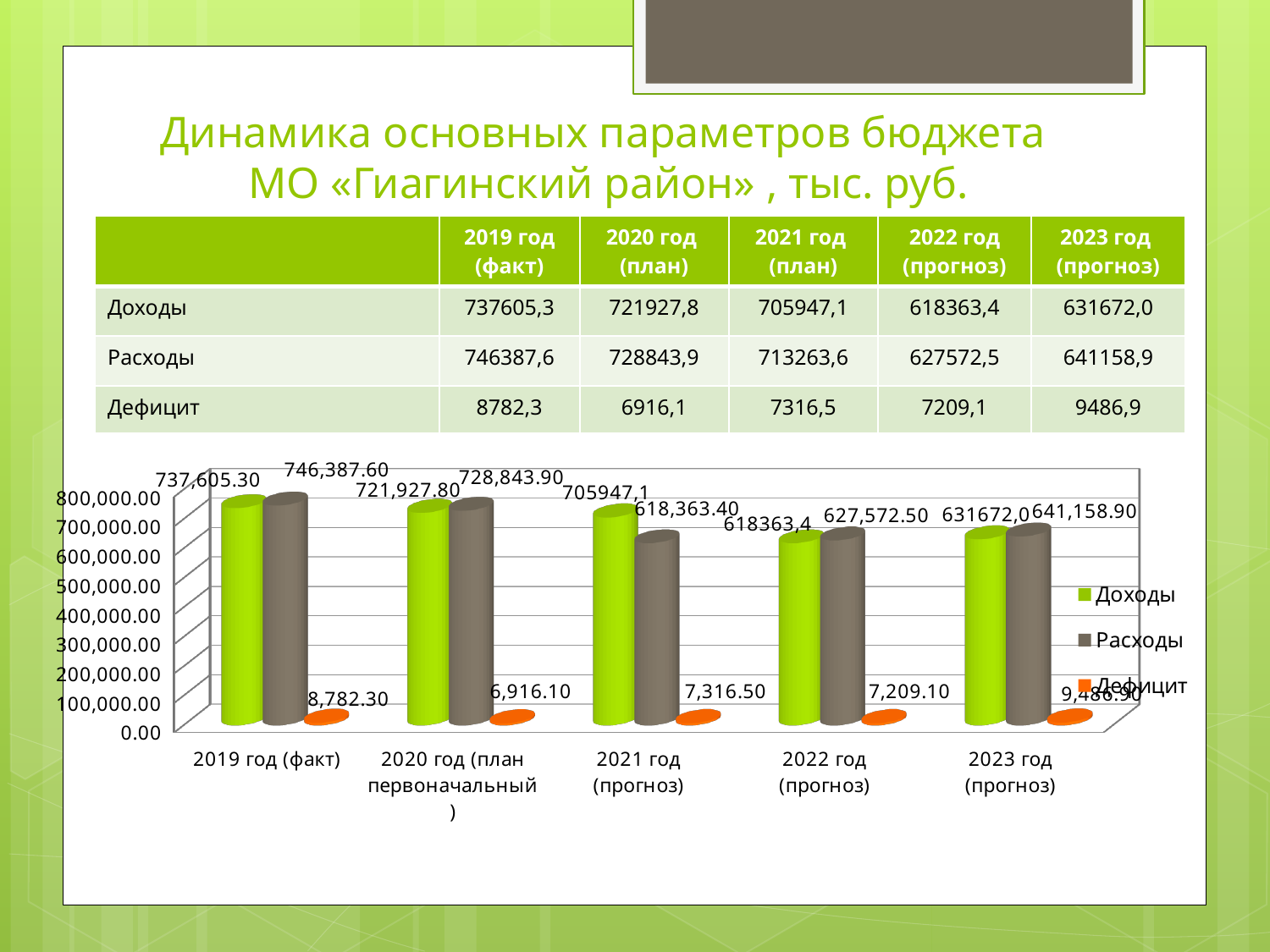
What is the value of Расходы for 2020 год (план первоначальный) on the chart? 728,843.90 Which year has the lowest Дефицит value on the chart? 2020 год (план первоначальный) How many series does the chart legend list? 3 Does the Доходы series rise or fall from 2019 год (факт) to 2022 год (прогноз) on the chart? fall Which is larger on the chart: Расходы for 2019 год (факт) or Расходы for 2023 год (прогноз)? Расходы for 2019 год (факт) Is the Доходы value for 2022 год (прогноз) greater or less than 700,000.00? less What is the value of Дефицит for 2023 год (прогноз) on the chart? 9,486.90 What is the value of Дефицит for 2022 год (прогноз) on the chart? 7,209.10 What is the value of Доходы for 2019 год (факт) on the chart? 737,605.30 How many year categories are shown on the chart's x axis? 5 What kind of chart is shown on the slide? bar chart Which year has the highest Доходы value on the chart? 2019 год (факт)